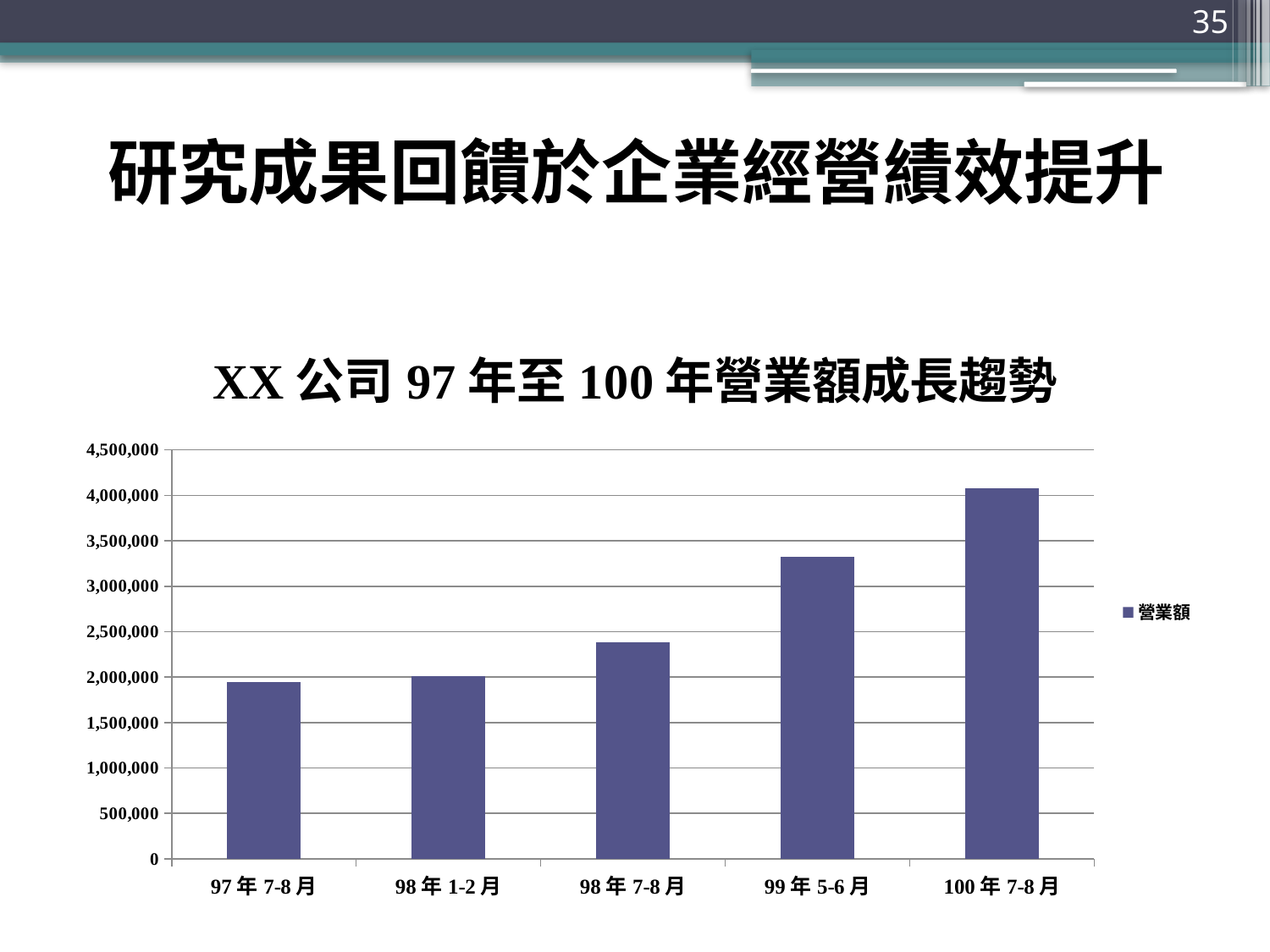
How many series does the chart's legend list? 1 What is the title of the chart? XX 公司 97 年至 100 年營業額成長趨勢 How many categories are shown on the x axis of the chart? 5 Is the value for 98 年 7-8 月 greater or less than 2,500,000? less Do the values in the chart rise or fall from left to right along the x axis? rise Which category has the highest value in the chart? 100 年 7-8 月 What series name is shown in the chart's legend? 營業額 Is the value for 97 年 7-8 月 greater or less than 1,500,000? greater Is the value for 99 年 5-6 月 greater or less than 3,000,000? greater What kind of chart is shown on the slide? bar chart Which is larger, the value for 99 年 5-6 月 or the value for 98 年 7-8 月? 99 年 5-6 月